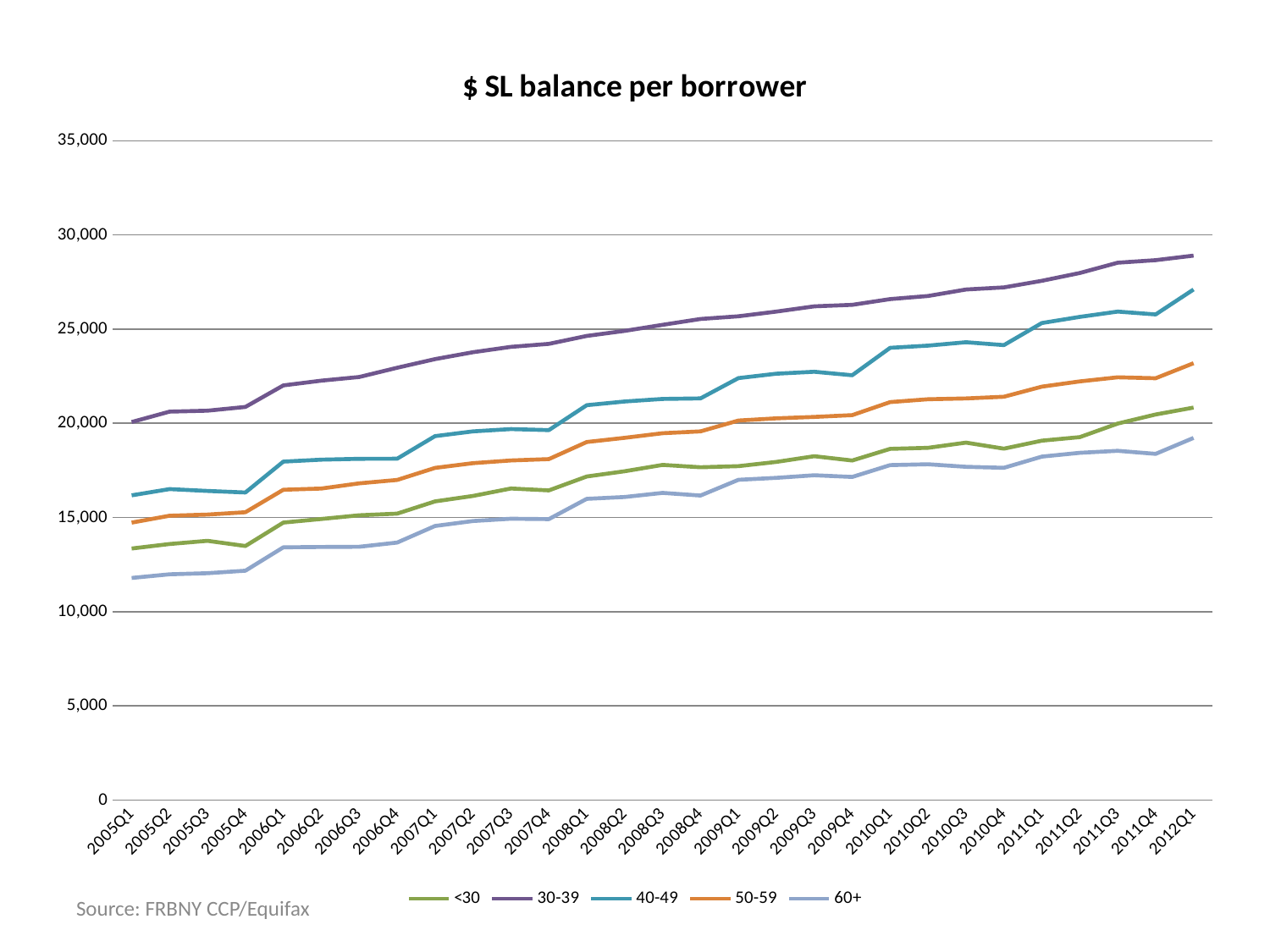
How many series does the legend list? 5 Is the value for the 60+ group in 2005Q1 greater or less than 15,000? less Which age group has the lowest $ SL balance per borrower in 2012Q1? 60+ In 2010Q1, which is larger: the value for the 40-49 group or the 50-59 group? 40-49 Is the value for the <30 group in 2012Q1 greater or less than 20,000? greater What is the title of the chart? $ SL balance per borrower Is the value for the 50-59 group in 2012Q1 greater or less than 25,000? less Which age group has the highest $ SL balance per borrower in 2012Q1? 30-39 How many quarters are plotted along the x axis? 29 Do the values for the 30-39 group rise or fall from 2005Q1 to 2012Q1? rise What kind of chart is shown on the slide? line chart